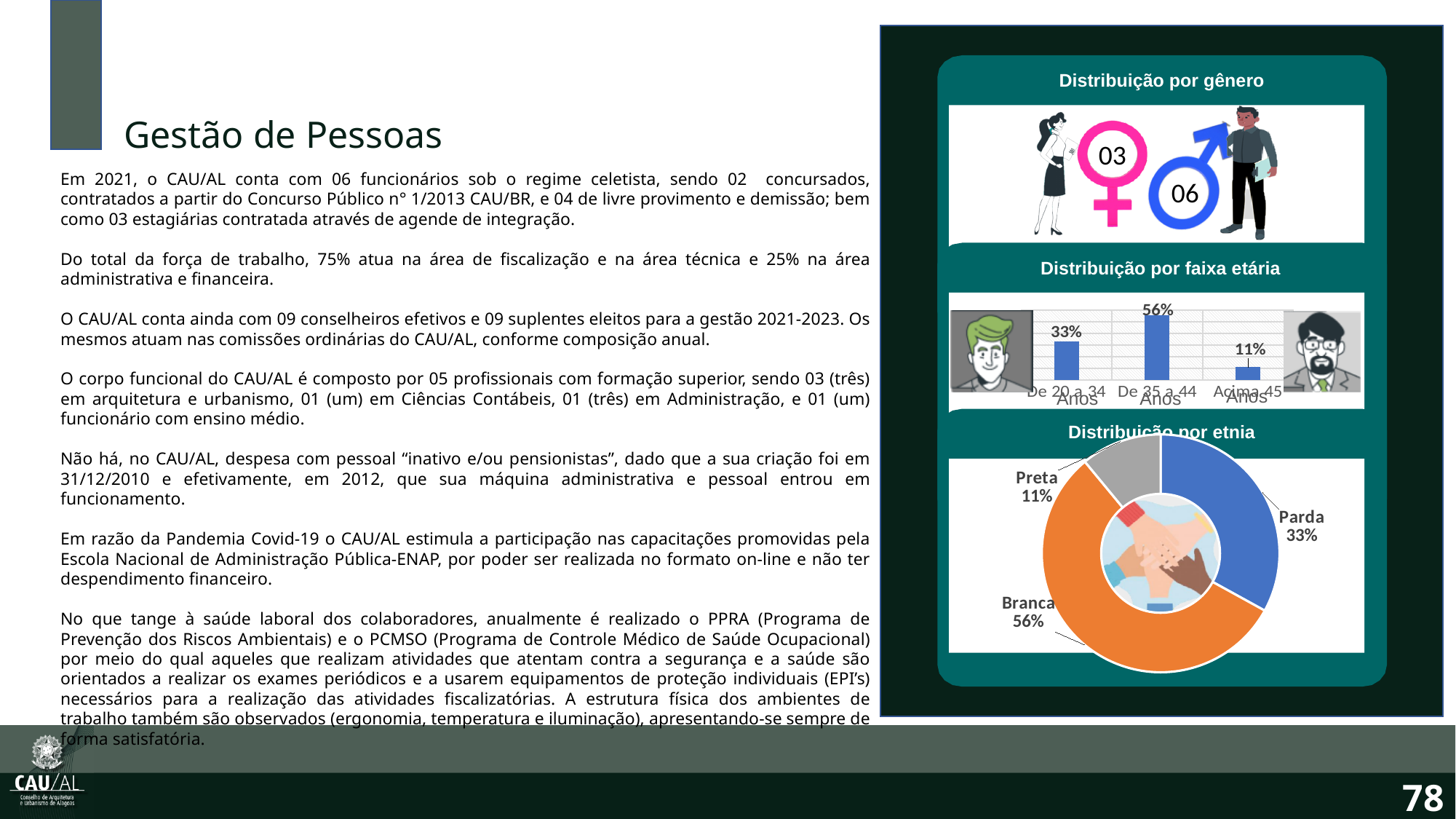
In the 'Distribuição por etnia' chart, which category has the largest slice? Branca In the 'Distribuição por etnia' chart, what is the value for 'Preta'? 11% In the 'Distribuição por faixa etária' chart, how many age groups are shown? 3 In the 'Distribuição por faixa etária' chart, what is the difference between 'De 35 a 44 Anos' and 'De 20 a 34 Anos'? 23% In the 'Distribuição por etnia' chart, which is larger, 'Parda' or 'Preta'? Parda In the 'Distribuição por faixa etária' chart, which age group has the lowest value? Acima 45 Anos In the 'Distribuição por faixa etária' chart, what is the value for 'Acima 45 Anos'? 11% In the 'Distribuição por etnia' chart, what share does 'Branca' have? 56% In the 'Distribuição por faixa etária' chart, which age group has the highest value? De 35 a 44 Anos What kind of chart is 'Distribuição por etnia'? Doughnut chart What kind of chart is 'Distribuição por faixa etária'? Bar chart In the 'Distribuição por faixa etária' chart, what is the value for 'De 35 a 44 Anos'? 56%